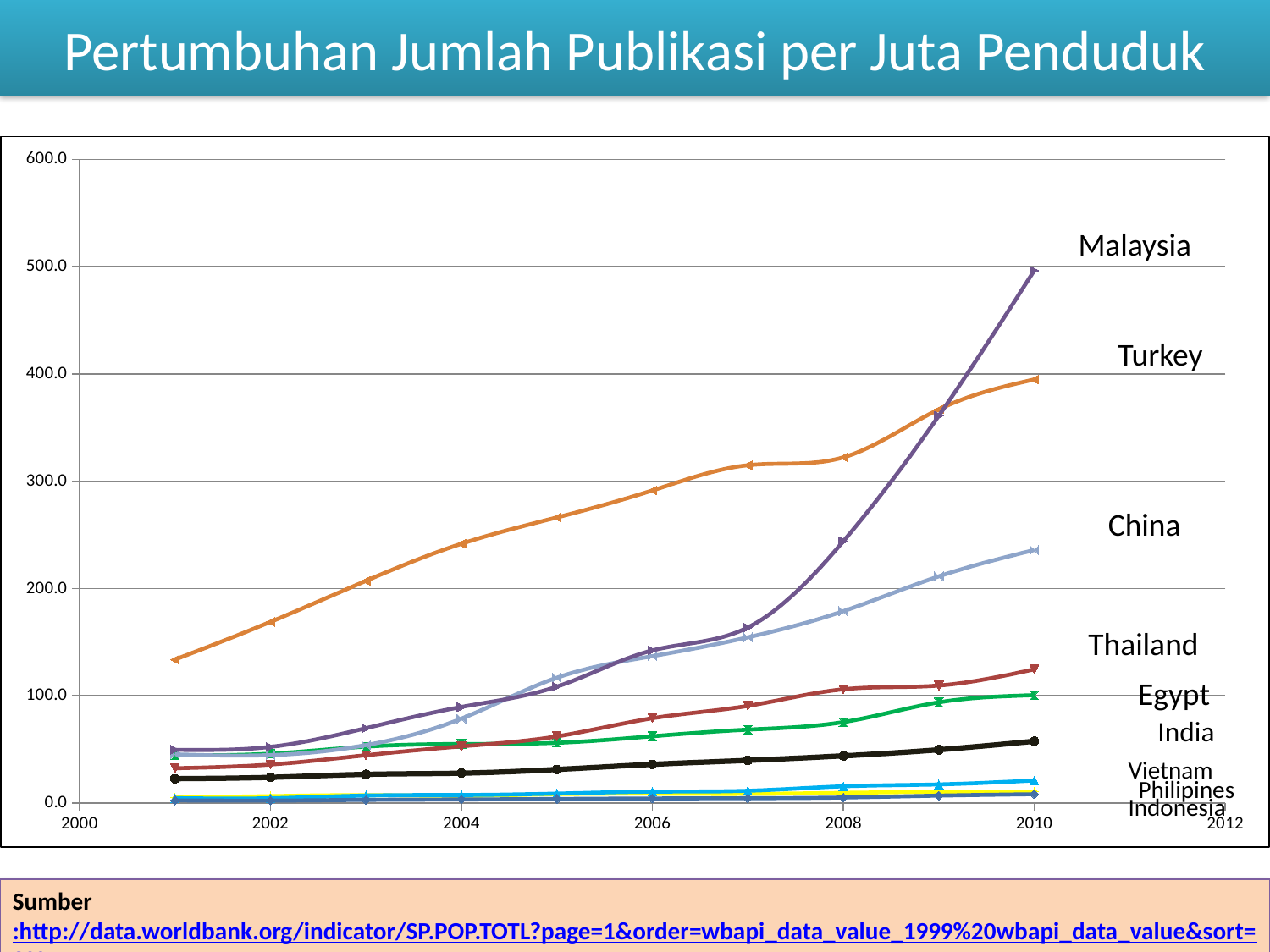
Which country has the highest value in 2008? Turkey In 2006, which is larger: the value for Turkey or the value for Malaysia? Turkey In 2010, which is larger: the value for China or the value for Thailand? China Does the value for Malaysia rise or fall from 2001 to 2010? rise What kind of chart is shown on the slide? line chart Is the value for India in 2010 greater or less than 100? less Is the value for Turkey in 2010 greater or less than 300? greater Is the value for China in 2010 greater or less than 200? greater What is the title of the chart on the slide? Pertumbuhan Jumlah Publikasi per Juta Penduduk How many countries (series) are labelled on the chart? 9 Which country has the highest value in 2010? Malaysia